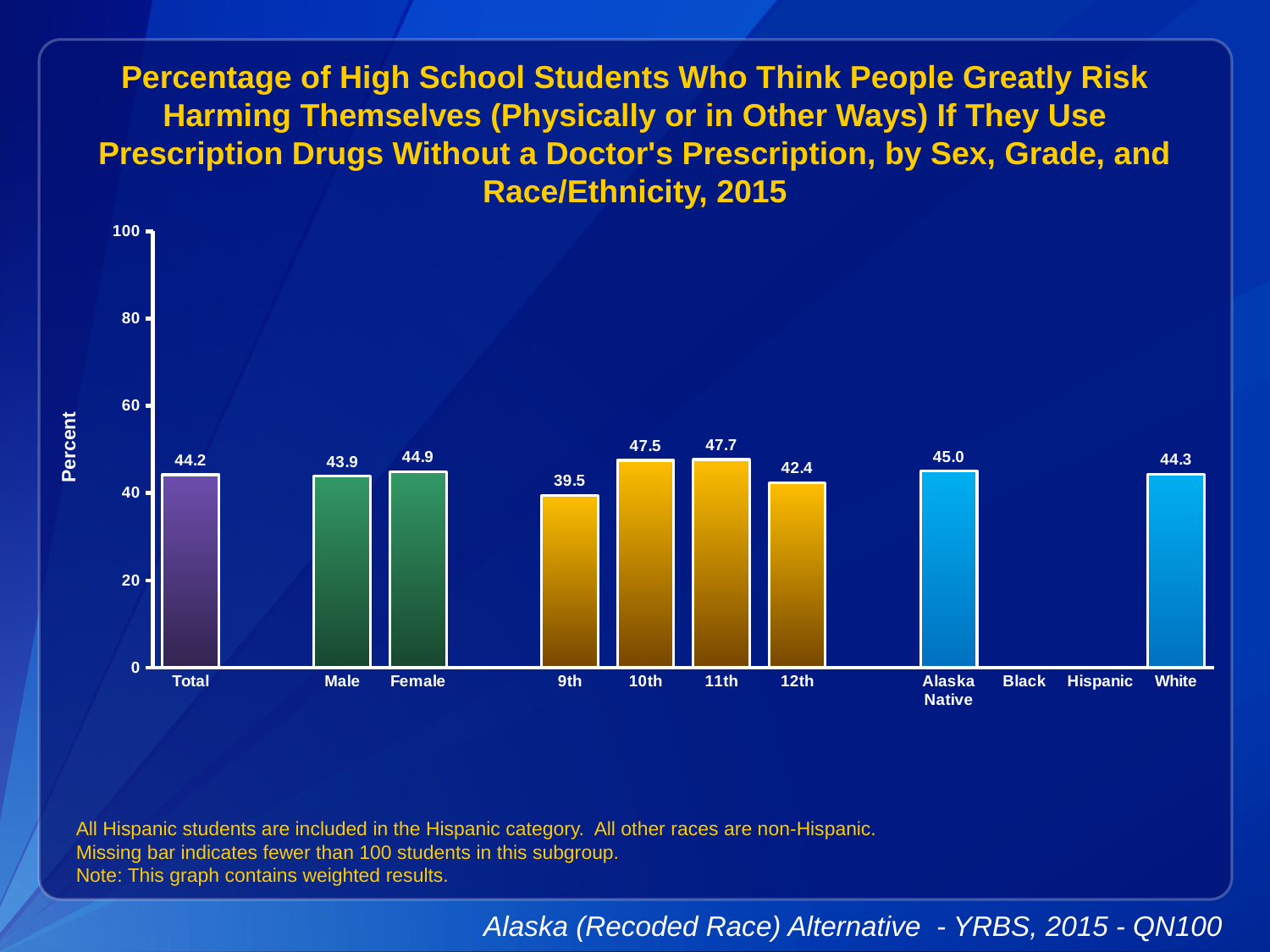
Which category has the highest value? 11th Which categories on the x axis have no bar? Black and Hispanic What is the value for Total? 44.2 Which is larger, the value for Male or the value for Female? Female What is the value for Female? 44.9 Is the value for 10th grade greater or less than 40? greater What kind of chart is shown? bar chart What is the difference between the values for 11th and 9th grade? 8.2 What is the value for 9th grade? 39.5 How many bars are plotted on the chart? 9 Which category has the lowest value among the bars shown? 9th What is the value for Alaska Native? 45.0